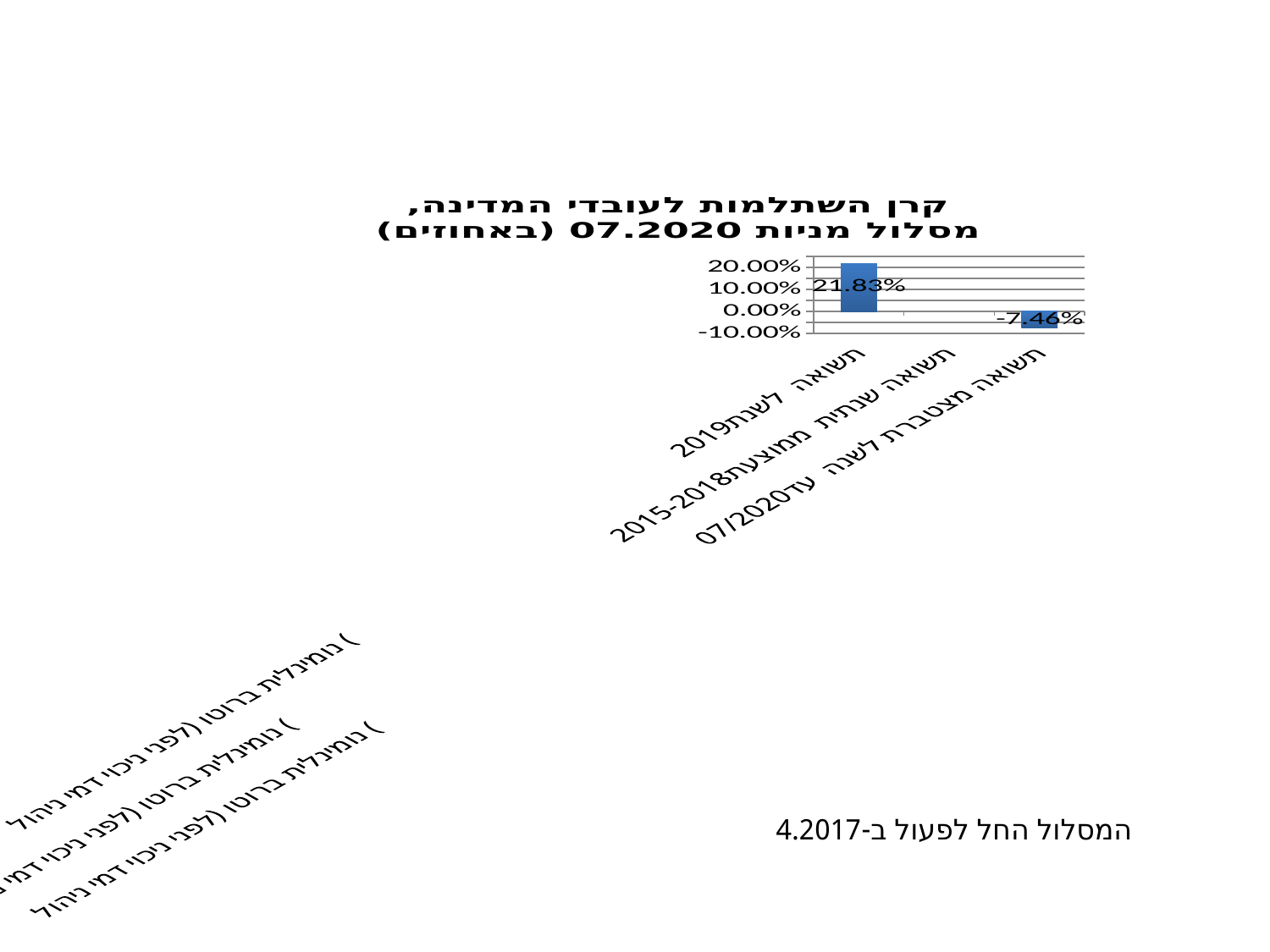
Which category has the highest value? תשואה לשנת 2019 What is the value for תשואה לשנת 2019? 21.83% How many categories are shown on the x axis? 3 What is the value for תשואה מצטברת לשנה עד 07/2020? -7.46% What is the title of the chart? קרן השתלמות לעובדי המדינה, מסלול מניות 07.2020 (באחוזים) Which category has the lowest plotted value? תשואה מצטברת לשנה עד 07/2020 Is the value for תשואה לשנת 2019 greater or less than 20.00%? greater Is the value for תשואה מצטברת לשנה עד 07/2020 greater or less than 0.00%? less What kind of chart is shown on the slide? bar chart What is the lowest value shown on the y axis? -10.00% Which is larger: the value for תשואה לשנת 2019 or the value for תשואה מצטברת לשנה עד 07/2020? תשואה לשנת 2019 What is the difference between the value for תשואה לשנת 2019 and the value for תשואה מצטברת לשנה עד 07/2020? 29.29%